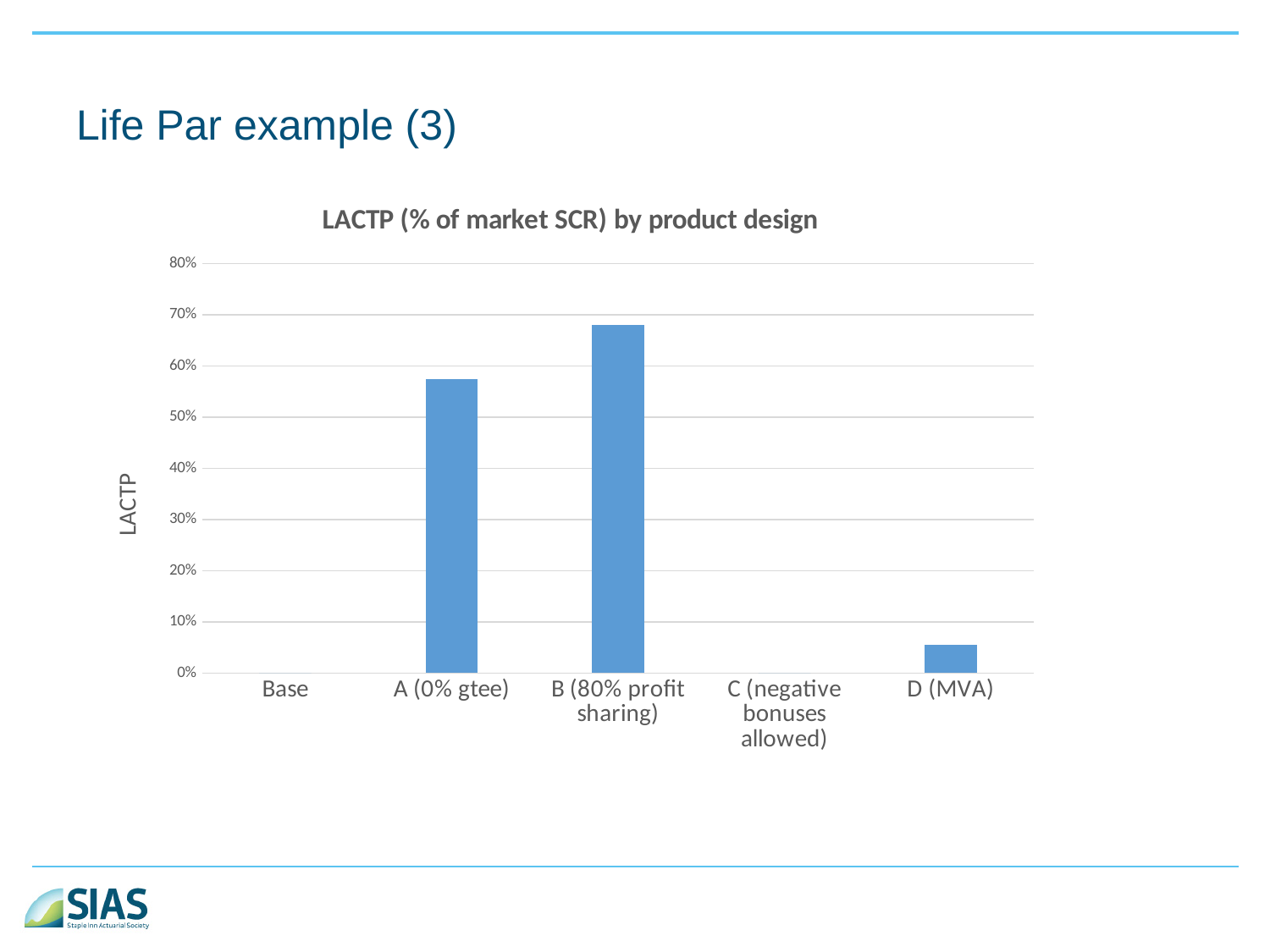
Is the value for C (negative bonuses allowed) greater or less than 10%? less What kind of chart is shown on the slide? bar chart Is the value for B (80% profit sharing) greater or less than 70%? less Which product design has the highest LACTP? B (80% profit sharing) Which is larger, the value for A (0% gtee) or the value for B (80% profit sharing)? B (80% profit sharing) Which is larger, the value for D (MVA) or the value for A (0% gtee)? A (0% gtee) How many product design categories are shown on the x axis? 5 What is the label on the vertical axis? LACTP What is the title of the chart? LACTP (% of market SCR) by product design Is the value for A (0% gtee) greater or less than 60%? less